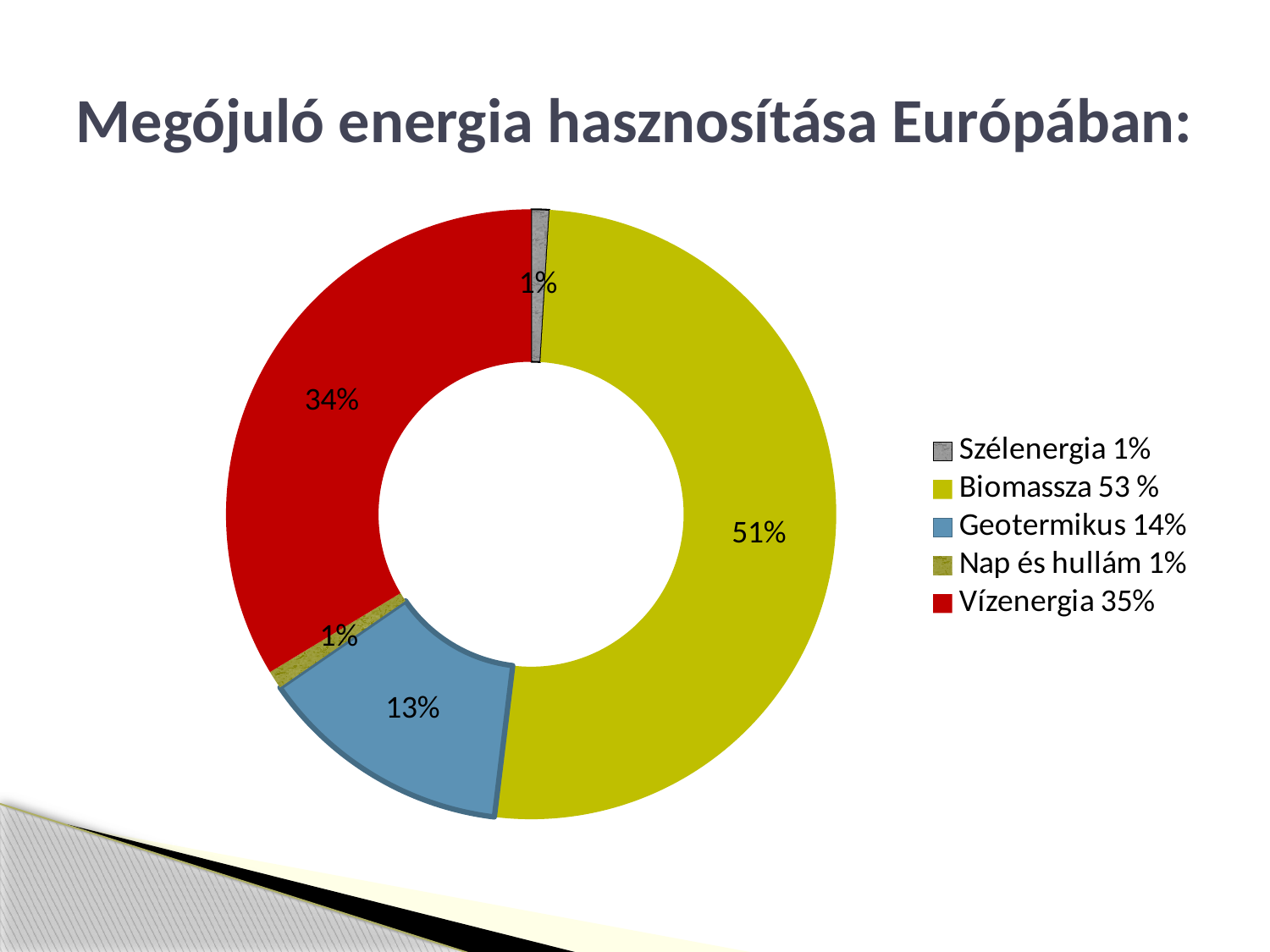
What data label is printed on the Geotermikus (blue) slice of the chart? 13% What data label is printed on the Biomassza (yellow-green) slice of the chart? 51% What kind of chart is shown on the slide? doughnut (pie) chart Which category has the largest slice in the chart? Biomassza According to the data labels, what is the difference between the Biomassza slice and the Vízenergia slice? 17% How many slices does the doughnut chart have? 5 What data label is printed on the Vízenergia (red) slice of the chart? 34% What is the title of the chart on the slide? Megójuló energia hasznosítása Európában: What data label is printed on the Szélenergia (grey) slice of the chart? 1% How many entries does the chart's legend list? 5 What percentage is shown next to Geotermikus in the chart's legend? 14% Which slice is larger in the chart, Vízenergia or Geotermikus? Vízenergia